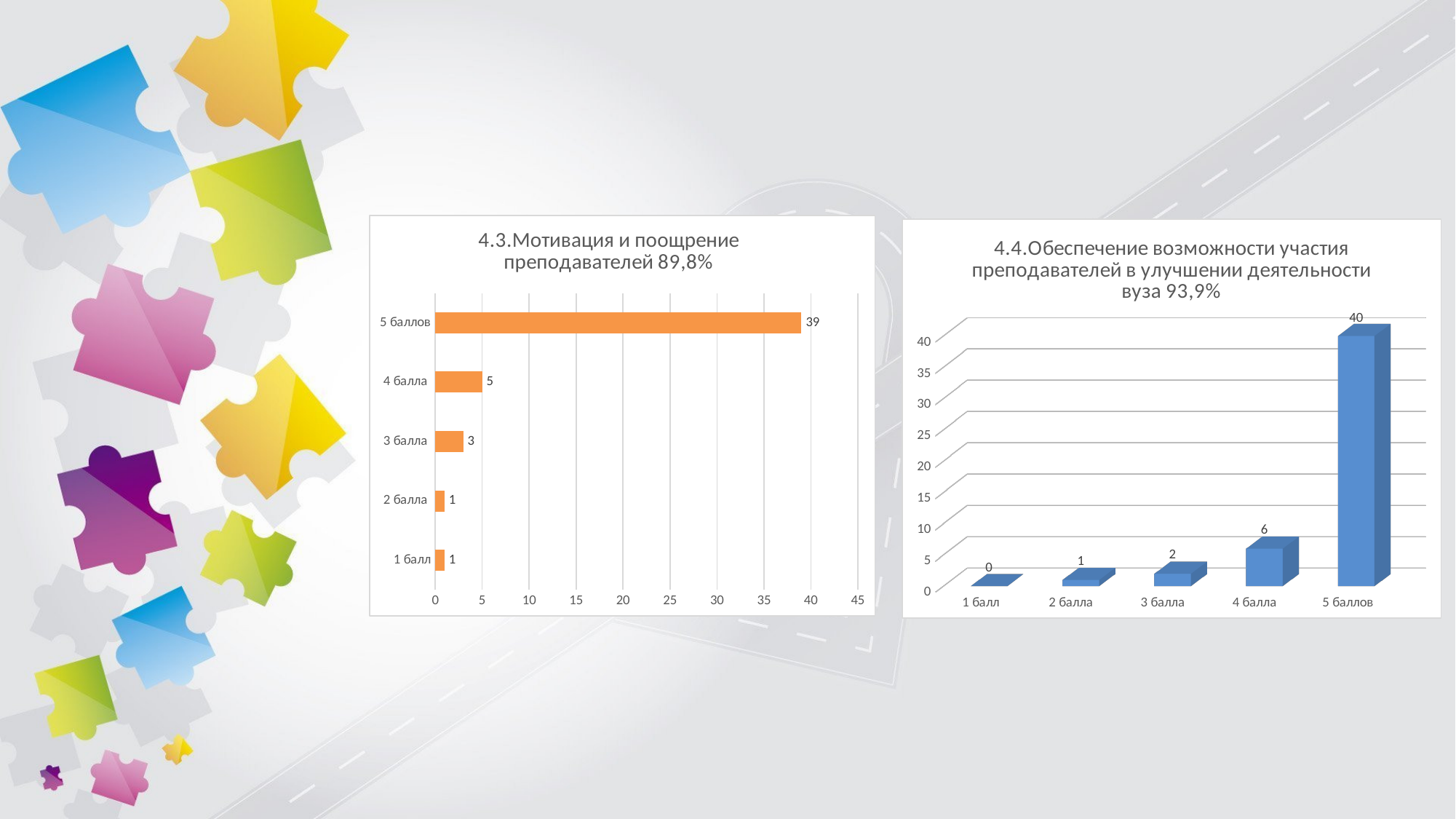
In the chart titled "4.3.Мотивация и поощрение преподавателей 89,8%", what is the value for 4 балла? 5 In the chart titled "4.3.Мотивация и поощрение преподавателей 89,8%", how many categories are shown? 5 In the chart titled "4.4.Обеспечение возможности участия преподавателей в улучшении деятельности вуза 93,9%", what is the value for 4 балла? 6 In the chart titled "4.4.Обеспечение возможности участия преподавателей в улучшении деятельности вуза 93,9%", which is larger, the value for 3 балла or the value for 4 балла? 4 балла What colour are the bars in the chart titled "4.3.Мотивация и поощрение преподавателей 89,8%"? orange In the chart titled "4.3.Мотивация и поощрение преподавателей 89,8%", what is the difference between the values for 5 баллов and 4 балла? 34 In the chart titled "4.4.Обеспечение возможности участия преподавателей в улучшении деятельности вуза 93,9%", what is the value for 5 баллов? 40 What kind of chart is the chart titled "4.3.Мотивация и поощрение преподавателей 89,8%"? bar chart In the chart titled "4.3.Мотивация и поощрение преподавателей 89,8%", which category has the highest value? 5 баллов In the chart titled "4.4.Обеспечение возможности участия преподавателей в улучшении деятельности вуза 93,9%", do the values rise or fall from 1 балл to 5 баллов? rise In the chart titled "4.4.Обеспечение возможности участия преподавателей в улучшении деятельности вуза 93,9%", which category has the lowest value? 1 балл In the chart titled "4.3.Мотивация и поощрение преподавателей 89,8%", what is the value for 5 баллов? 39